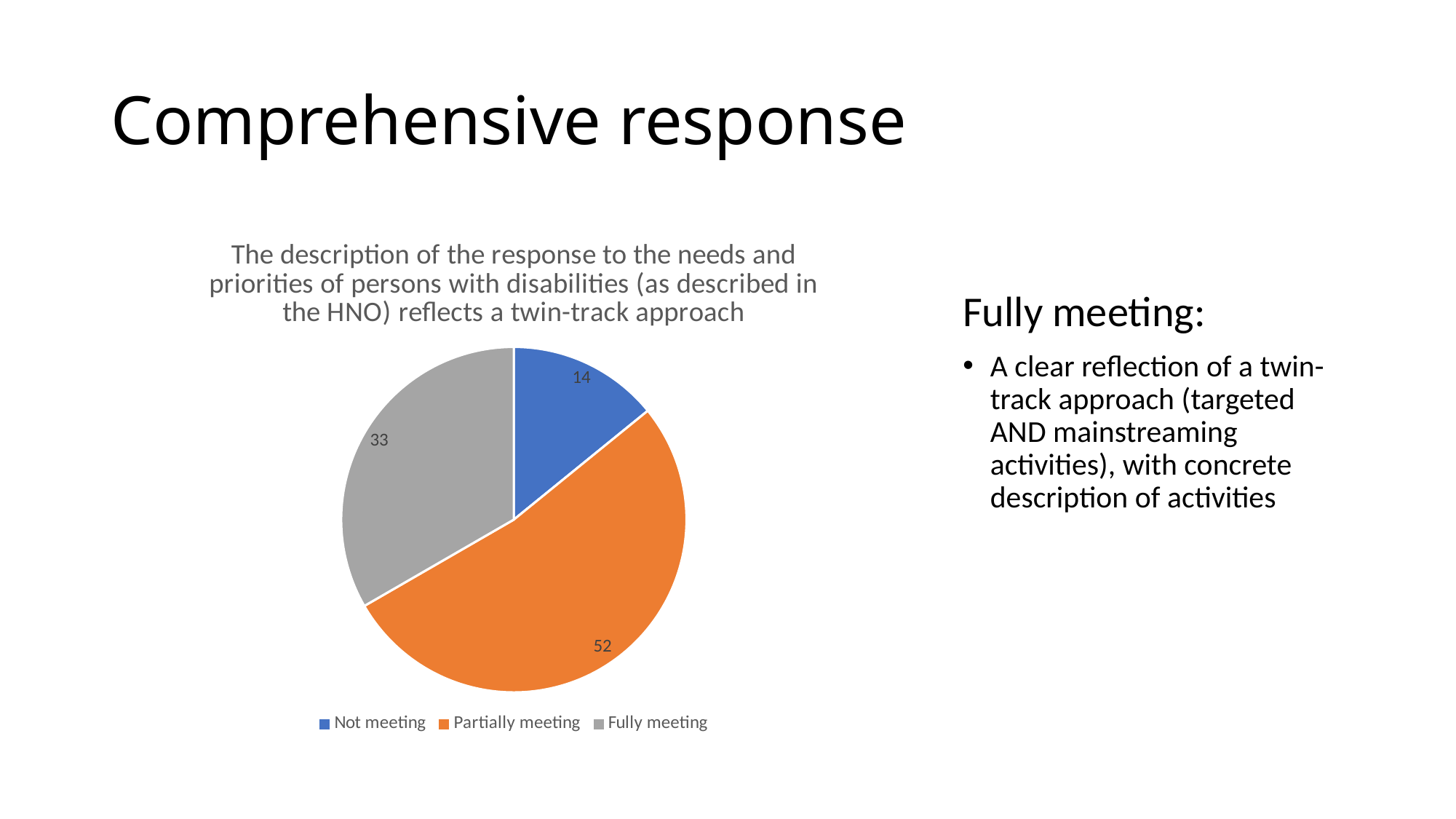
What type of chart is shown on the slide? pie chart What is the difference between the values for Partially meeting and Fully meeting? 19 Which category has the smallest slice? Not meeting What is the value for Fully meeting? 33 Which category is shown in grey? Fully meeting Which category has the largest slice? Partially meeting What is the value for Partially meeting? 52 What colour is the Partially meeting slice? orange What is the difference between the values for Fully meeting and Not meeting? 19 How many categories does the pie chart have? 3 What is the value for Not meeting? 14 Which is larger, the value for Fully meeting or the value for Not meeting? Fully meeting